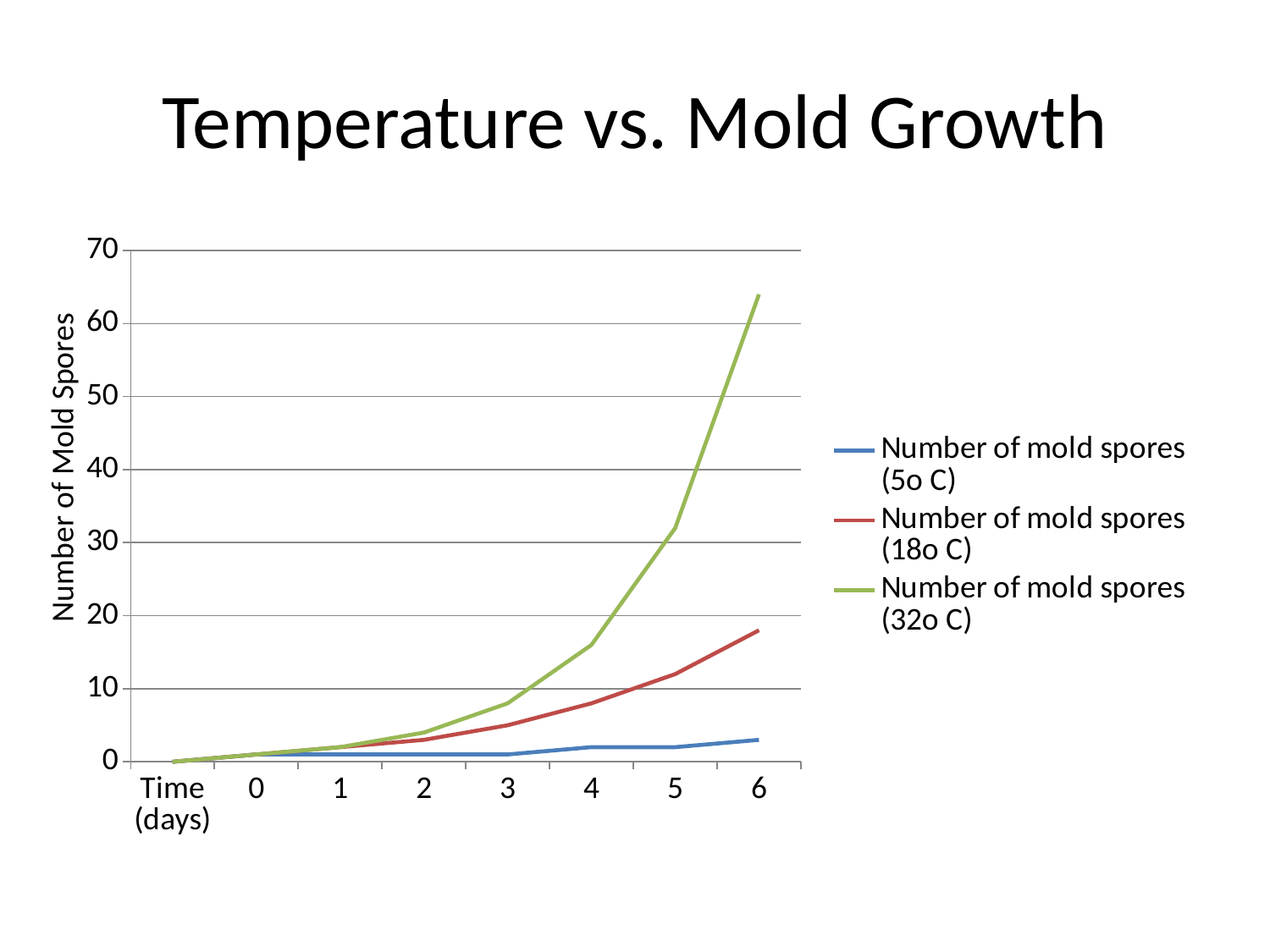
Which series has the lowest value at day 6? Number of mold spores (5o C) How many series does the legend list? 3 Does the Number of mold spores (32o C) series rise or fall as the days increase? rise Is the value for Number of mold spores (32o C) at day 6 greater or less than 60? greater Is the value for Number of mold spores (32o C) at day 4 greater or less than 10? greater At day 6, which is larger: Number of mold spores (32o C) or Number of mold spores (18o C)? Number of mold spores (32o C) What is the title of the chart? Temperature vs. Mold Growth What is the label on the vertical axis? Number of Mold Spores Which series has the highest value at day 6? Number of mold spores (32o C) What kind of chart is shown on the slide? line chart Is the value for Number of mold spores (18o C) at day 6 greater or less than 10? greater